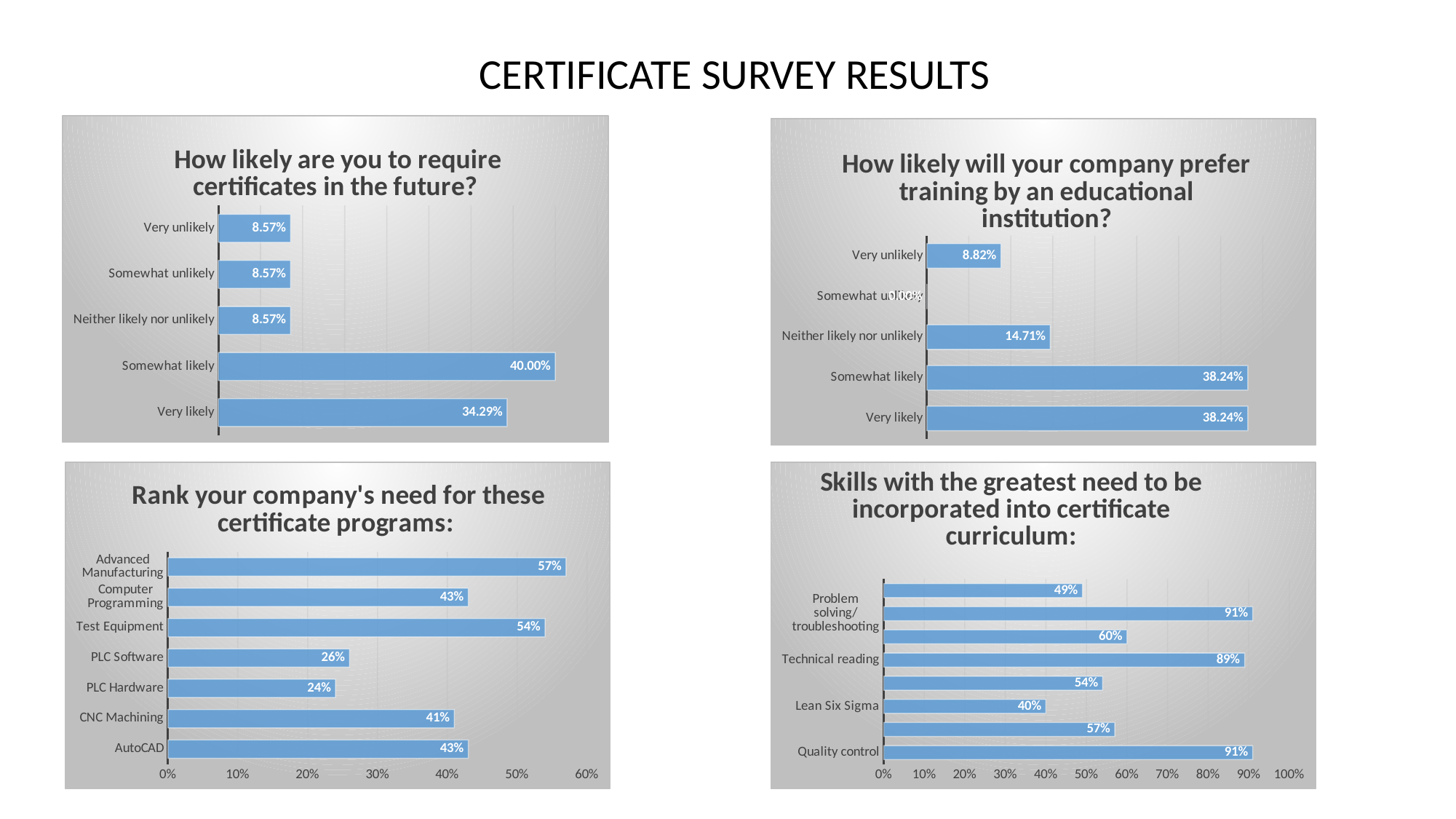
In the chart 'How likely are you to require certificates in the future?', what is the value for Somewhat likely? 40.00% In the chart 'How likely are you to require certificates in the future?', which category has the highest value? Somewhat likely In the chart 'How likely are you to require certificates in the future?', what is the value for Very likely? 34.29% In the chart 'Skills with the greatest need to be incorporated into certificate curriculum:', what is the value for Lean Six Sigma? 40% In the chart 'Rank your company's need for these certificate programs:', which program has the highest value? Advanced Manufacturing In the chart 'Rank your company's need for these certificate programs:', how many certificate programs are listed? 7 In the chart 'Rank your company's need for these certificate programs:', what is the value for Test Equipment? 54% In the chart 'How likely will your company prefer training by an educational institution?', what is the value for Very unlikely? 8.82% In the chart 'Skills with the greatest need to be incorporated into certificate curriculum:', what is the value for Quality control? 91% In the chart 'How likely will your company prefer training by an educational institution?', what is the value for Neither likely nor unlikely? 14.71% In the chart 'Rank your company's need for these certificate programs:', which program has the lowest value? PLC Hardware In the chart 'How likely are you to require certificates in the future?', what is the difference between Somewhat likely and Very likely? 5.71%